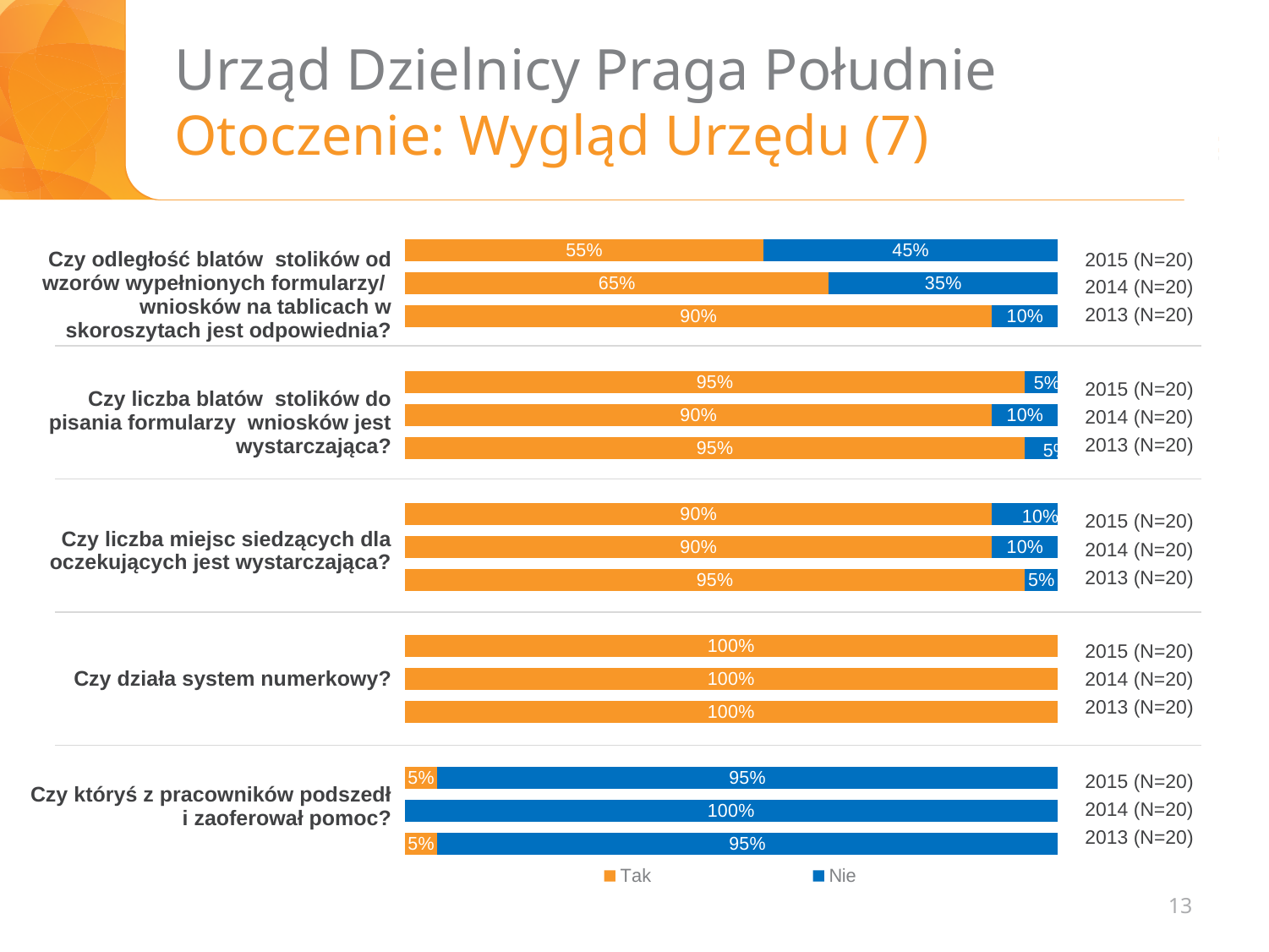
In the chart for "Czy odległość blatów stolików od wzorów wypełnionych formularzy/wniosków na tablicach w skoroszytach jest odpowiednia?", what is the difference between the Tak values for 2013 and 2015? 35% In the chart for "Czy działa system numerkowy?", what is the Tak value for 2014 (N=20)? 100% In the chart for "Czy liczba miejsc siedzących dla oczekujących jest wystarczająca?", what is the Tak value for 2013 (N=20)? 95% In the chart for "Czy liczba miejsc siedzących dla oczekujących jest wystarczająca?", is the Tak value for 2015 larger or smaller than the Tak value for 2013? smaller In the chart for "Czy któryś z pracowników podszedł i zaoferował pomoc?", what is the total of the stacked bar for 2013 (N=20)? 100% How many series does the legend at the bottom of the slide list? 2 In the chart for "Czy któryś z pracowników podszedł i zaoferował pomoc?", what is the Nie value for 2015 (N=20)? 95% In the chart for "Czy odległość blatów stolików od wzorów wypełnionych formularzy/wniosków na tablicach w skoroszytach jest odpowiednia?", what is the Nie value for 2014 (N=20)? 35% In the chart for "Czy liczba blatów stolików do pisania formularzy wniosków jest wystarczająca?", what is the Nie value for 2014 (N=20)? 10% In the chart for "Czy liczba blatów stolików do pisania formularzy wniosków jest wystarczająca?", which year has the lowest Tak value? 2014 (N=20) In the chart for "Czy odległość blatów stolików od wzorów wypełnionych formularzy/wniosków na tablicach w skoroszytach jest odpowiednia?", which year has the highest Tak value? 2013 (N=20) In the chart for "Czy odległość blatów stolików od wzorów wypełnionych formularzy/wniosków na tablicach w skoroszytach jest odpowiednia?", what is the Tak value for 2015 (N=20)? 55%